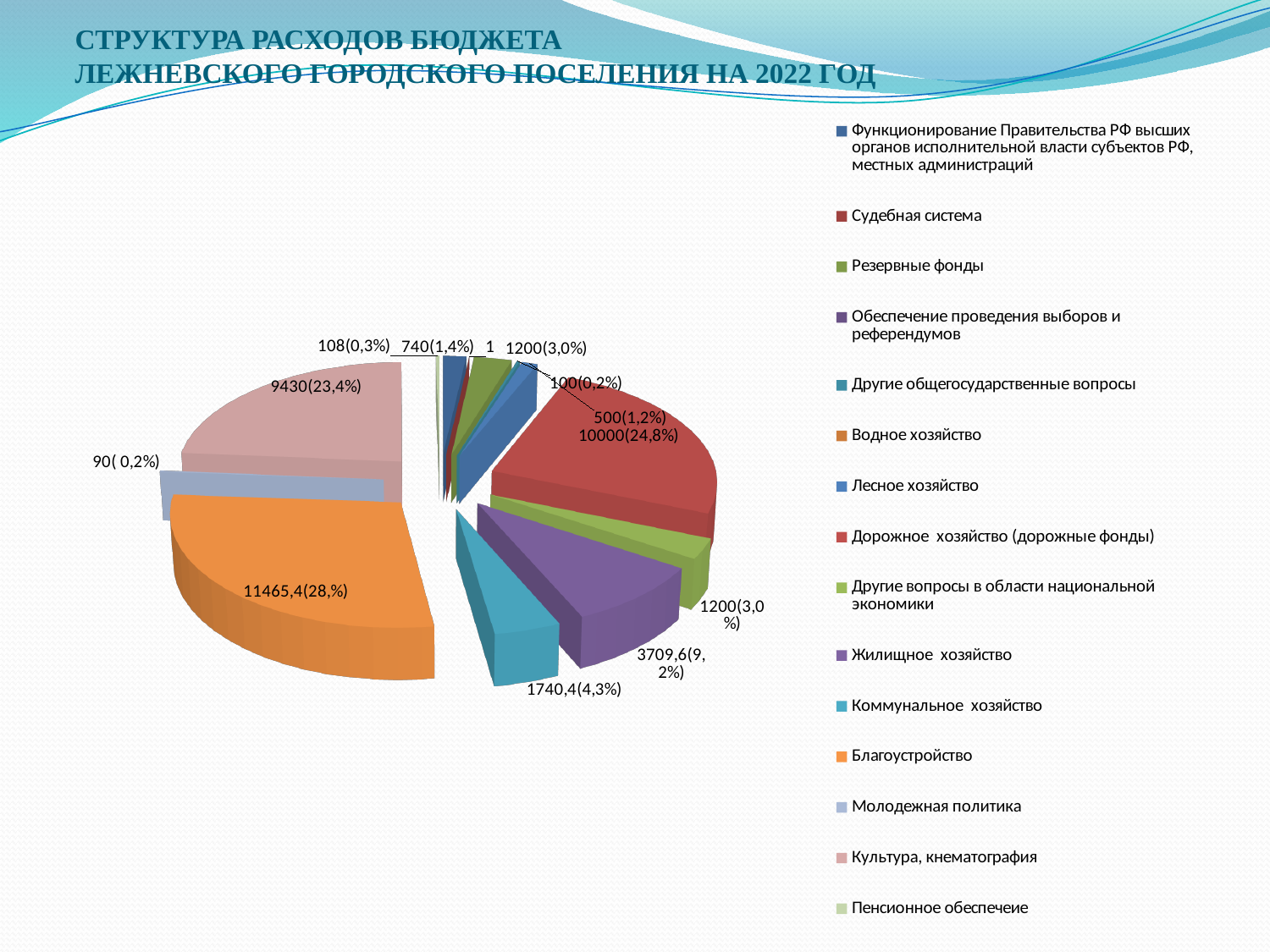
What is the title of the slide containing the pie chart? СТРУКТУРА РАСХОДОВ БЮДЖЕТА ЛЕЖНЕВСКОГО ГОРОДСКОГО ПОСЕЛЕНИЯ НА 2022 ГОД What kind of chart is shown on the slide? pie chart Which category has the largest slice of the pie? Благоустройство How many categories does the legend of the pie chart list? 15 What is the difference between the Дорожное хозяйство (дорожные фонды) value (10000) and the Культура, кнематография value (9430)? 570 What data label is shown for the Благоустройство slice? 11465,4(28,%) What data label is shown for the Жилищное хозяйство slice? 3709,6(9,2%) What data label is shown for the Дорожное хозяйство (дорожные фонды) slice? 10000(24,8%) Which slice is larger: Дорожное хозяйство (дорожные фонды) or Культура, кнематография? Дорожное хозяйство (дорожные фонды) What share of the pie does the Дорожное хозяйство (дорожные фонды) slice represent? 24,8% What data label is shown for the Коммунальное хозяйство slice? 1740,4(4,3%) What data label is shown for the Культура, кнематография slice? 9430(23,4%)